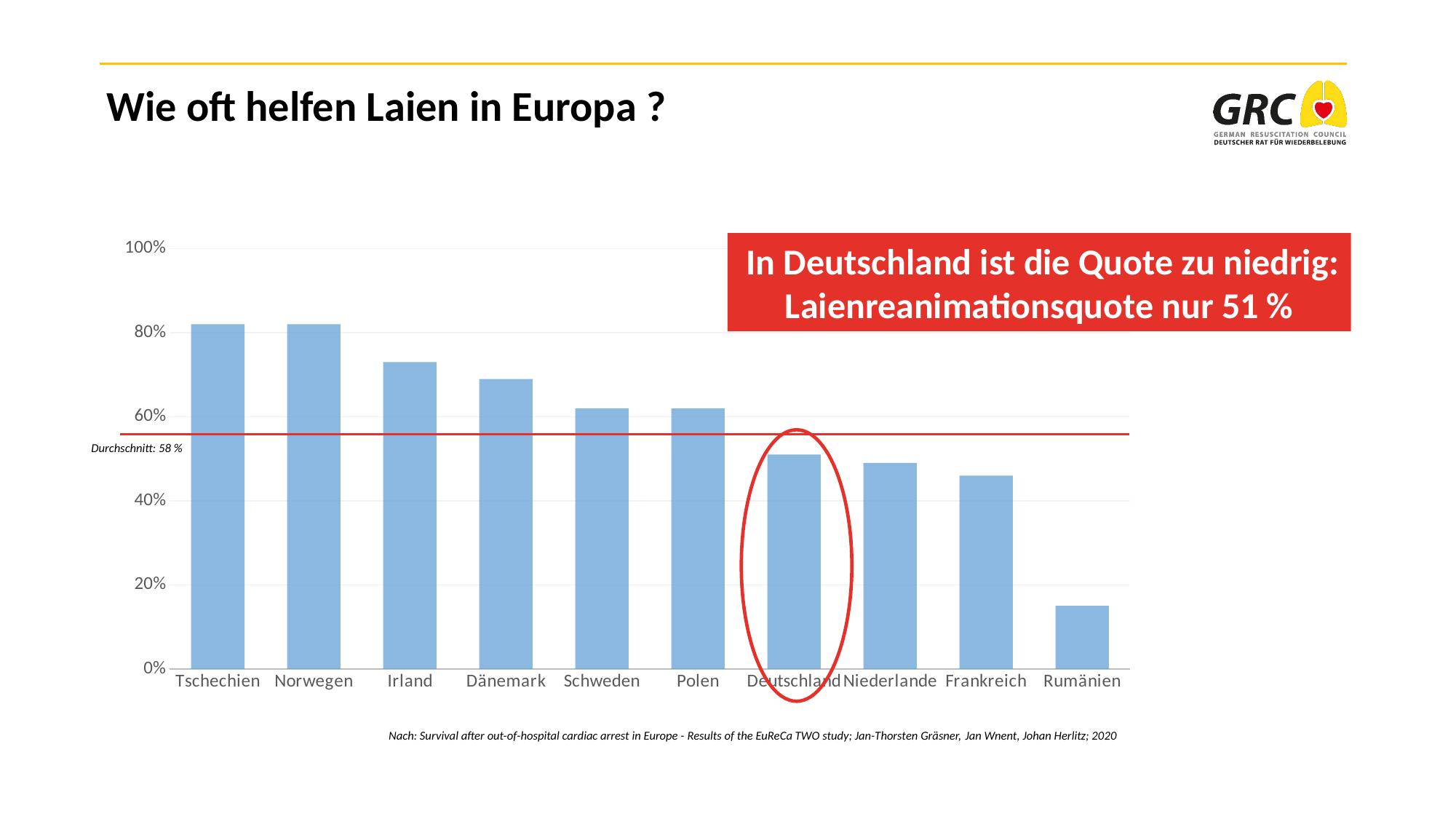
Is the value for Rumänien greater or less than 20%? less What kind of chart is shown on the slide? bar chart Which has the larger value, Polen or Rumänien? Polen What average value (Durchschnitt) is marked by the red horizontal line in the chart? 58 % Is the value for Niederlande greater or less than 40%? greater Which country has the lowest value in the chart? Rumänien Is the value for Frankreich greater or less than 60%? less What is the Laienreanimationsquote for Deutschland according to the slide? 51 % How many countries are shown on the x axis of the chart? 10 Do the bar values generally rise or fall from left to right along the x axis? fall Which has the larger value, Irland or Frankreich? Irland